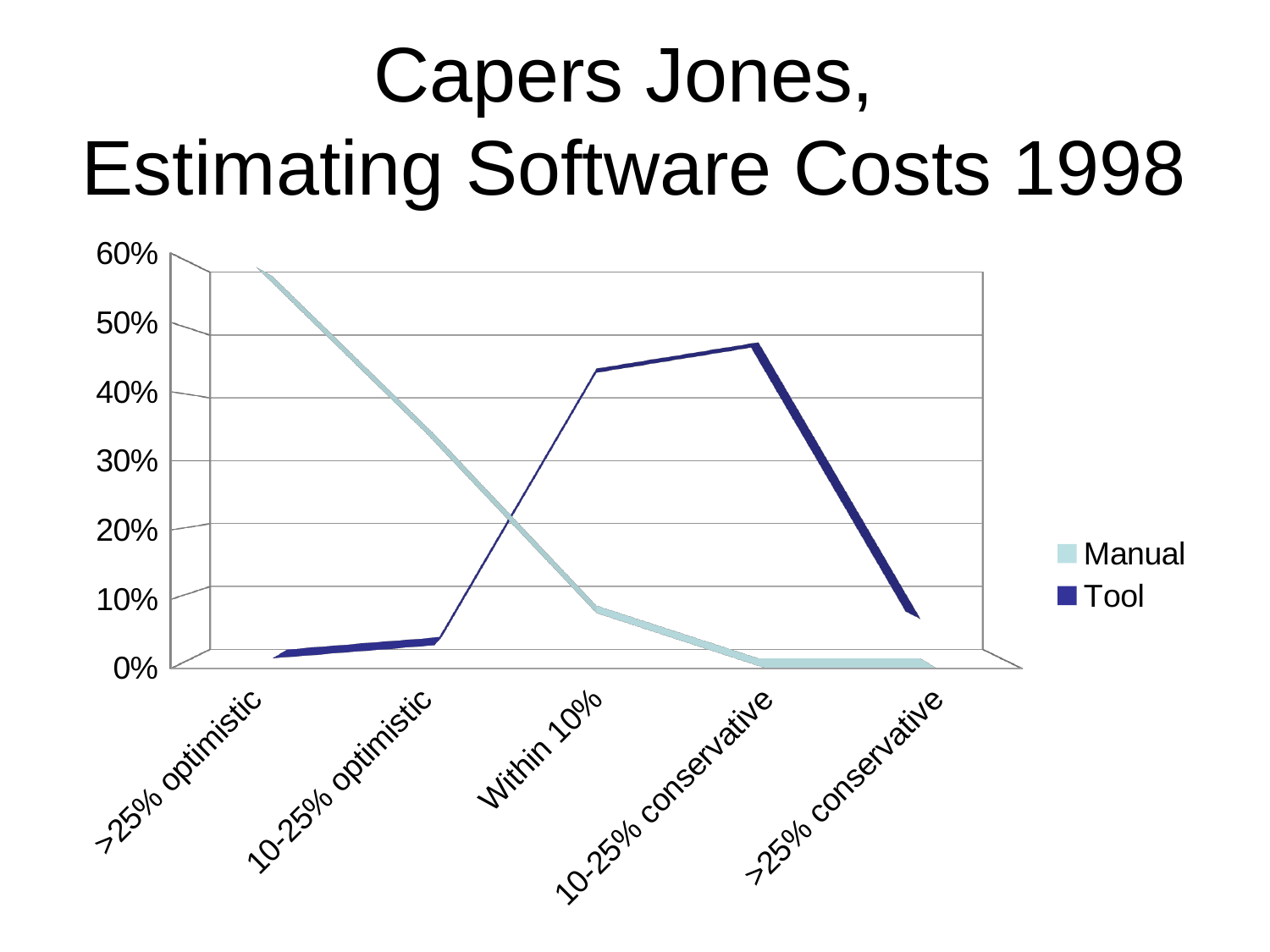
How many series does the legend list? 2 Is the Manual value for 10-25% optimistic greater or less than 40%? less Is the Tool value for 10-25% conservative greater or less than 40%? greater Which category has the highest value for the Manual series? >25% optimistic What kind of chart is shown on the slide? Line chart How many categories are shown on the x axis? 5 What are the two series named in the legend? Manual and Tool Does the Manual series rise or fall moving from >25% optimistic to >25% conservative? Fall Is the Manual value for >25% optimistic greater or less than 50%? greater At Within 10%, which series has the larger value, Manual or Tool? Tool Which category has the highest value for the Tool series? 10-25% conservative